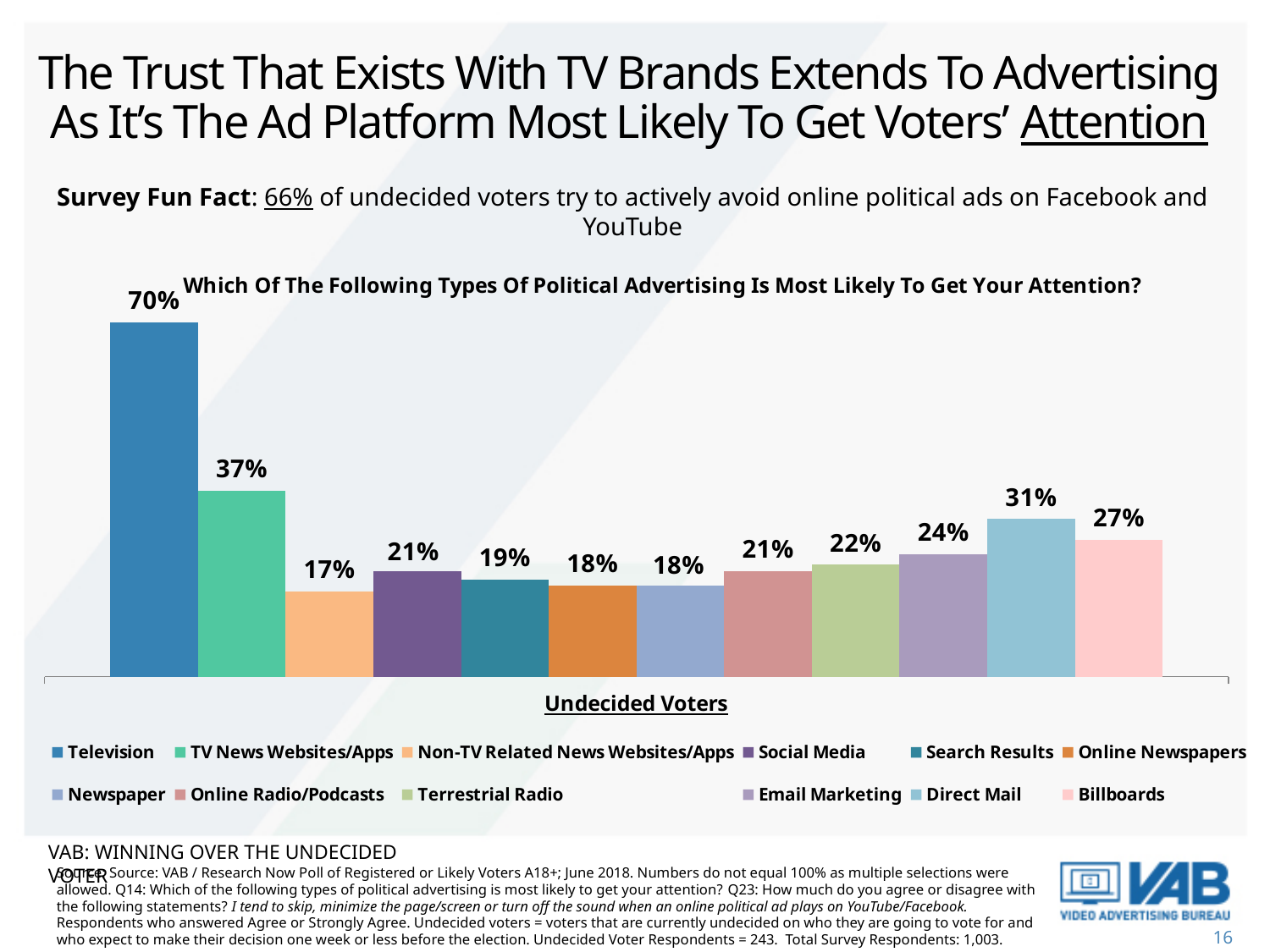
What is the value shown for Direct Mail? 31% What kind of chart is shown on the slide? Bar chart Which has a larger value, Terrestrial Radio or Search Results? Terrestrial Radio Which type of political advertising has the lowest value in the chart? Non-TV Related News Websites/Apps What is the difference between the values for Direct Mail and Billboards? 4% What is the title of the chart? Which Of The Following Types Of Political Advertising Is Most Likely To Get Your Attention? What is the value shown for Email Marketing? 24% What is the value shown for TV News Websites/Apps? 37% Which type of political advertising has the highest value in the chart? Television How many series does the legend list? 12 What is the difference between the values for Television and TV News Websites/Apps? 33% What percentage of undecided voters said Television is the type of political advertising most likely to get their attention? 70%